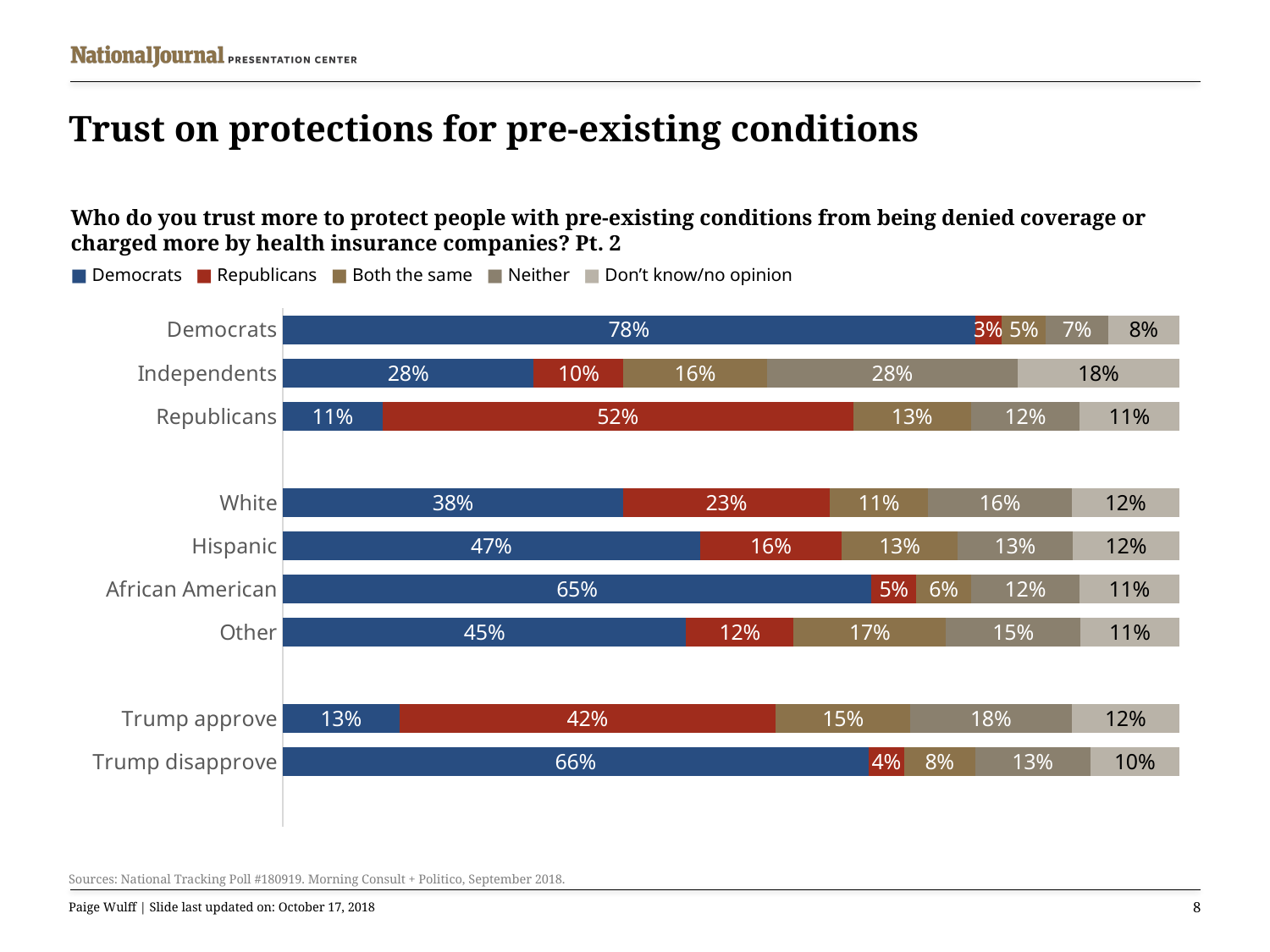
How many response options does the legend list? 5 What is the total of the Independents bar? 100% Which group has the lowest share trusting Republicans more? Democrats How many groups (bars) are shown in the chart? 9 What percentage of Democrats trust Democrats more to protect people with pre-existing conditions? 78% Which group has the highest share trusting Democrats more? Democrats What percentage of Republicans trust Republicans more on this question? 52% Who has a larger share trusting Republicans more: White respondents or Trump approvers? Trump approvers How much higher is the 'Democrats' share among African Americans than among Hispanics? 18 percentage points What percentage of Trump approvers trust Democrats more? 13% What type of chart is shown on the slide? Stacked bar chart What share of Independents answered 'Neither'? 28%